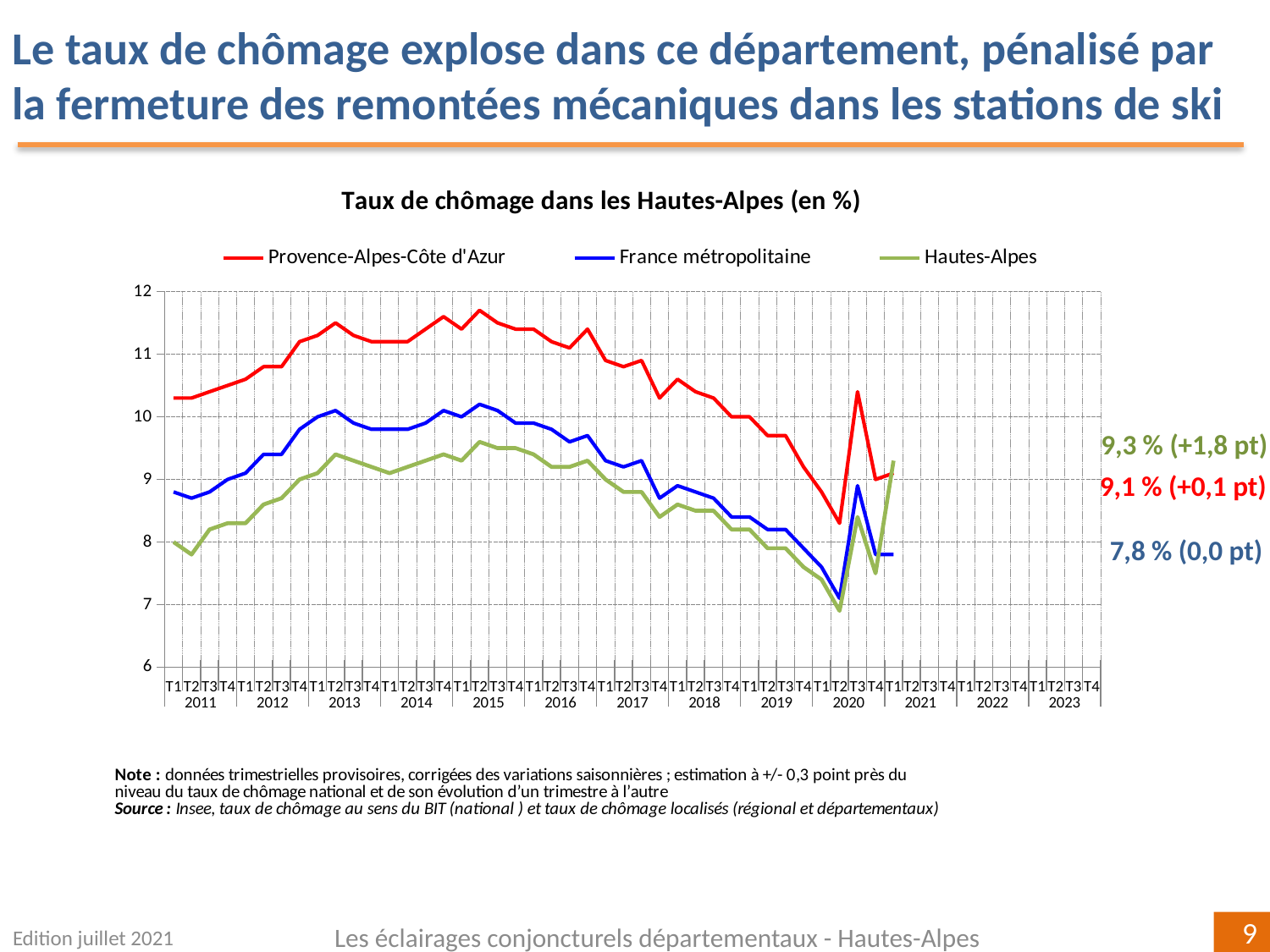
What is the title of the chart? Taux de chômage dans les Hautes-Alpes (en %) What kind of chart is shown on the slide? line chart What is the latest unemployment rate shown for France métropolitaine? 7,8 % Which series has the lowest value at the latest point? France métropolitaine By how many points did the Hautes-Alpes rate change according to the label next to its latest value? +1,8 pt How many series does the legend list? 3 At the latest point, which is higher: Hautes-Alpes or Provence-Alpes-Côte d'Azur? Hautes-Alpes Is the value for France métropolitaine in T2 2020 greater or less than 8? less Is the value for Provence-Alpes-Côte d'Azur in T2 2013 greater or less than 11? greater What is the difference between the latest Hautes-Alpes rate and the latest France métropolitaine rate? 1,5 pt What is the latest unemployment rate shown for Hautes-Alpes? 9,3 % What is the latest unemployment rate shown for Provence-Alpes-Côte d'Azur? 9,1 %